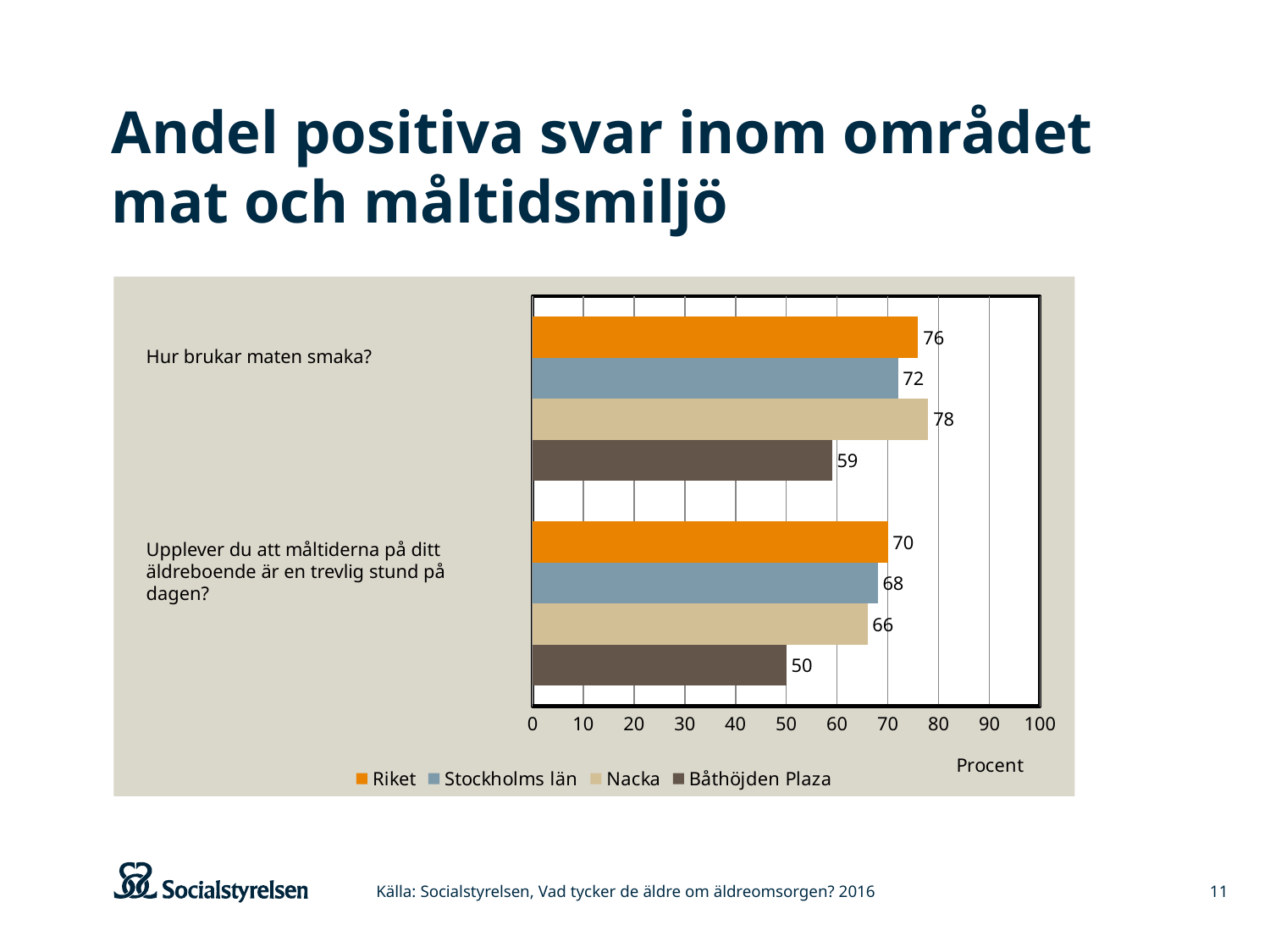
What unit is shown on the horizontal axis of the chart? Procent What kind of chart is shown on the slide? bar chart What is the difference between the Nacka and Båthöjden Plaza values for "Hur brukar maten smaka?"? 19 What is the value for Nacka on the question "Hur brukar maten smaka?"? 78 How many questions (categories) are shown on the chart? 2 Which series has the highest value for "Hur brukar maten smaka?"? Nacka What is the value for Riket on the question "Hur brukar maten smaka?"? 76 What is the value for Båthöjden Plaza on the question "Upplever du att måltiderna på ditt äldreboende är en trevlig stund på dagen?"? 50 Which series has the lowest value for "Upplever du att måltiderna på ditt äldreboende är en trevlig stund på dagen?"? Båthöjden Plaza Which is larger for "Upplever du att måltiderna på ditt äldreboende är en trevlig stund på dagen?": Riket or Stockholms län? Riket Is the value for Båthöjden Plaza on "Hur brukar maten smaka?" greater or less than 60? less How many series does the legend list? 4